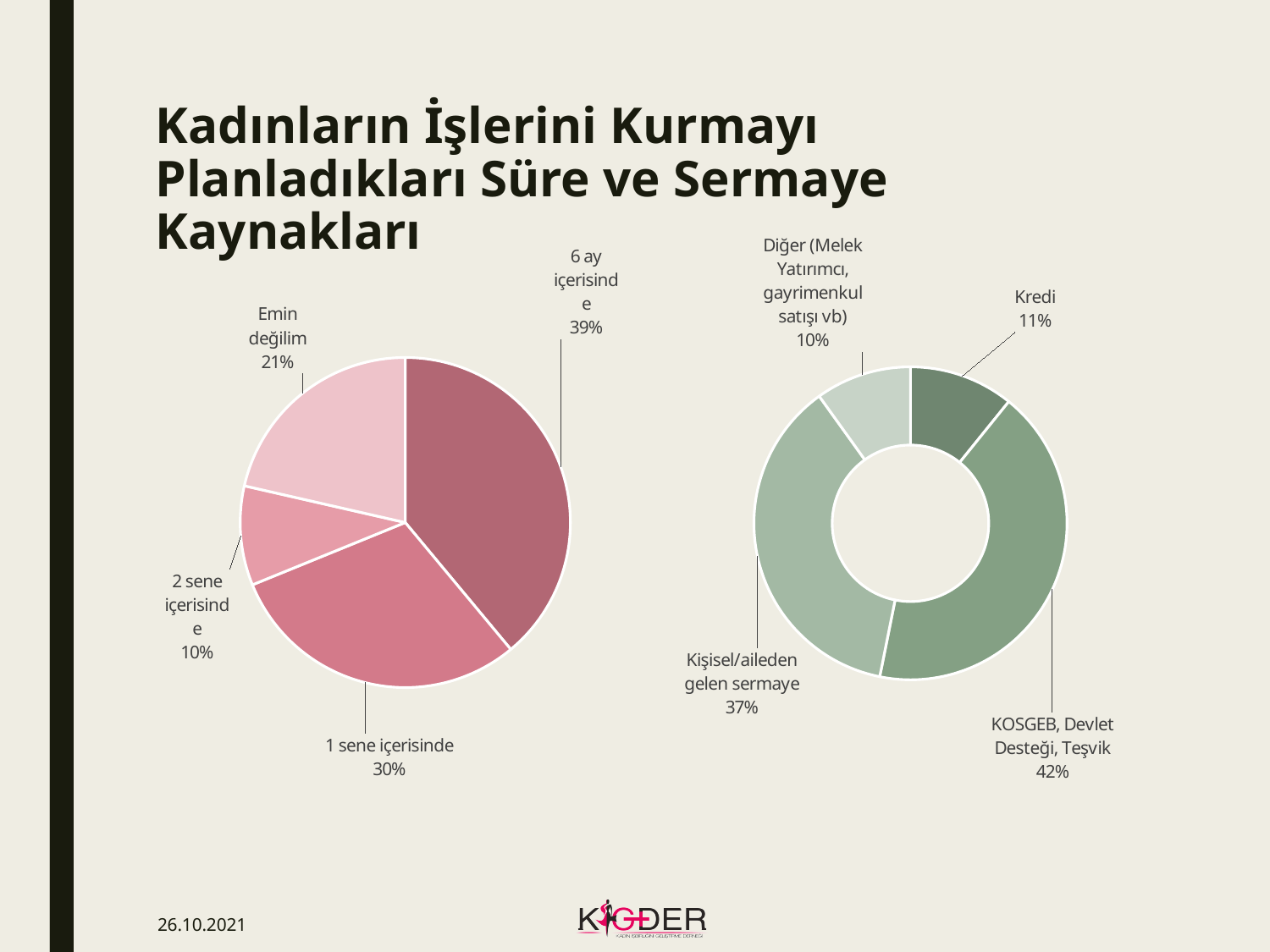
What type of chart is the chart on the right of the slide? Doughnut chart In the right doughnut chart, what share is labelled for "Kişisel/aileden gelen sermaye"? 37% In the right doughnut chart, what share is labelled for "Kredi"? 11% In the left pie chart, what share is labelled for "Emin değilim"? 21% In the right doughnut chart, what is the difference in percentage points between "KOSGEB, Devlet Desteği, Teşvik" and "Kişisel/aileden gelen sermaye"? 5 In the left pie chart, what is the difference in percentage points between "1 sene içerisinde" and "2 sene içerisinde"? 20 In the left pie chart, what share is labelled for "6 ay içerisinde"? 39% How many slices does the left pie chart have? 4 In the right doughnut chart, which is larger: "Kredi" or "Diğer (Melek Yatırımcı, gayrimenkul satışı vb)"? Kredi In the right doughnut chart, which category has the largest share? KOSGEB, Devlet Desteği, Teşvik In the left pie chart, which category has the largest share? 6 ay içerisinde In the left pie chart, which category has the smallest share? 2 sene içerisinde